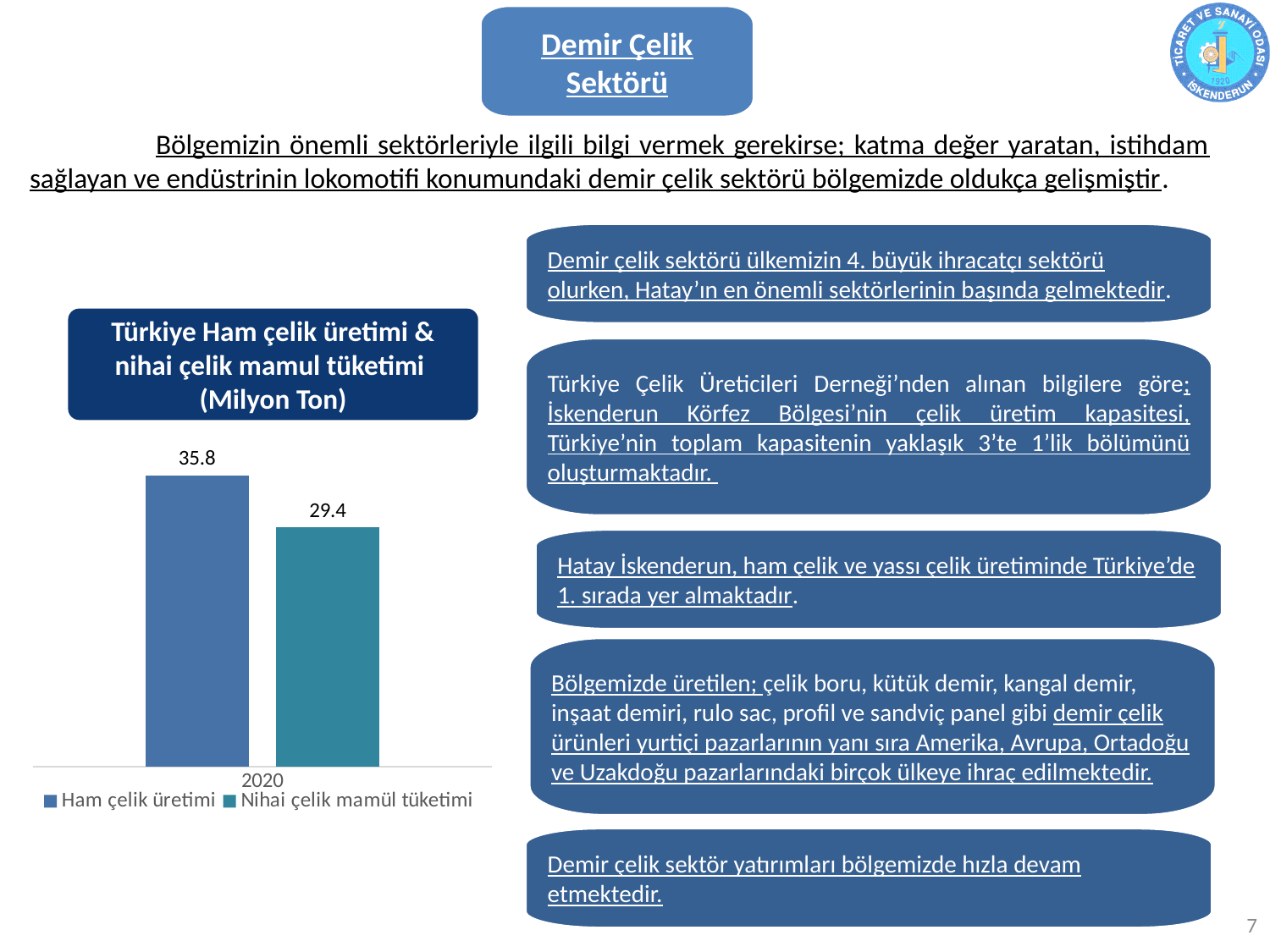
How many series does the legend list? 2 How many categories are shown on the x axis of the chart? 1 What is the value for Nihai çelik mamül tüketimi in 2020? 29.4 Which series has the lowest value in the chart? Nihai çelik mamül tüketimi What year is shown on the x axis of the chart? 2020 What is the value for Ham çelik üretimi in 2020? 35.8 What is the difference between Ham çelik üretimi and Nihai çelik mamül tüketimi in 2020? 6.4 Which series has the higher value in 2020, Ham çelik üretimi or Nihai çelik mamül tüketimi? Ham çelik üretimi What kind of chart is shown on the slide? bar chart What is the title of the chart? Türkiye Ham çelik üretimi & nihai çelik mamul tüketimi (Milyon Ton)